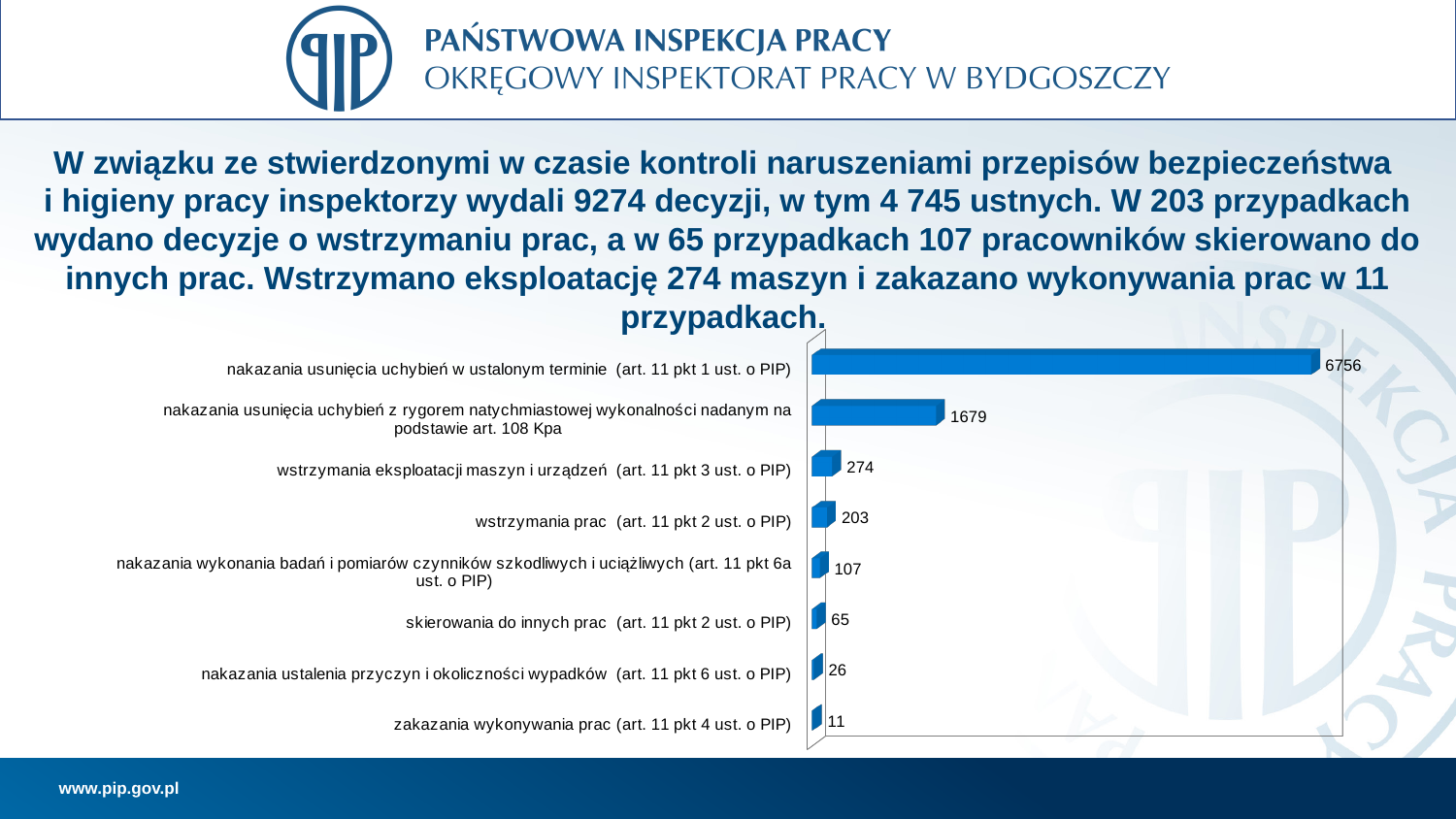
What is the difference between the values for 'nakazania usunięcia uchybień w ustalonym terminie' and 'nakazania usunięcia uchybień z rygorem natychmiastowej wykonalności'? 5077 What value is shown for 'wstrzymania eksploatacji maszyn i urządzeń (art. 11 pkt 3 ust. o PIP)'? 274 How many categories are shown in the chart? 8 What kind of chart is shown on the slide? bar chart Which is larger: the value for 'nakazania wykonania badań i pomiarów czynników szkodliwych i uciążliwych' or the value for 'skierowania do innych prac'? nakazania wykonania badań i pomiarów czynników szkodliwych i uciążliwych Which category has the highest value? nakazania usunięcia uchybień w ustalonym terminie (art. 11 pkt 1 ust. o PIP) What value is shown for 'nakazania usunięcia uchybień z rygorem natychmiastowej wykonalności nadanym na podstawie art. 108 Kpa'? 1679 What is the difference between the values for 'wstrzymania eksploatacji maszyn i urządzeń' and 'wstrzymania prac'? 71 What value is shown for 'nakazania ustalenia przyczyn i okoliczności wypadków (art. 11 pkt 6 ust. o PIP)'? 26 What colour are the bars in the chart? blue What value is shown for 'skierowania do innych prac (art. 11 pkt 2 ust. o PIP)'? 65 Which category has the lowest value? zakazania wykonywania prac (art. 11 pkt 4 ust. o PIP)